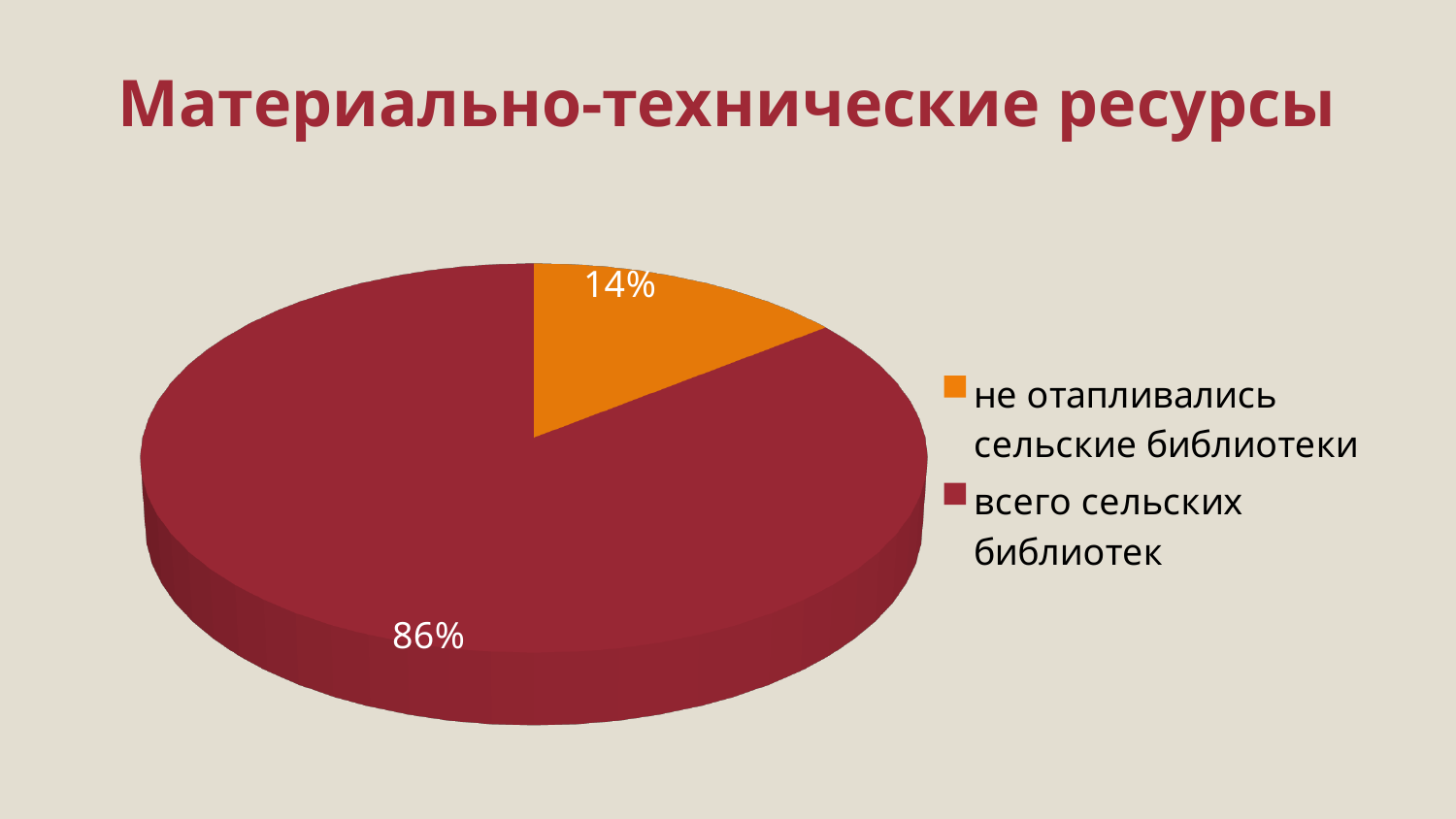
What colour is the "не отапливались сельские библиотеки" slice? Orange What kind of chart is shown on the slide? Pie chart Which slice of the pie is the smallest? не отапливались сельские библиотеки Which is larger: the "не отапливались сельские библиотеки" slice or the "всего сельских библиотек" slice? всего сельских библиотек What is the title of the slide containing the chart? Материально-технические ресурсы Which slice of the pie is the largest? всего сельских библиотек What is the difference in percentage points between the "всего сельских библиотек" slice and the "не отапливались сельские библиотеки" slice? 72 What share of the pie is labelled for "не отапливались сельские библиотеки"? 14% How many slices does the pie chart have? 2 How many entries does the legend list? 2 What share of the pie is labelled for "всего сельских библиотек"? 86%